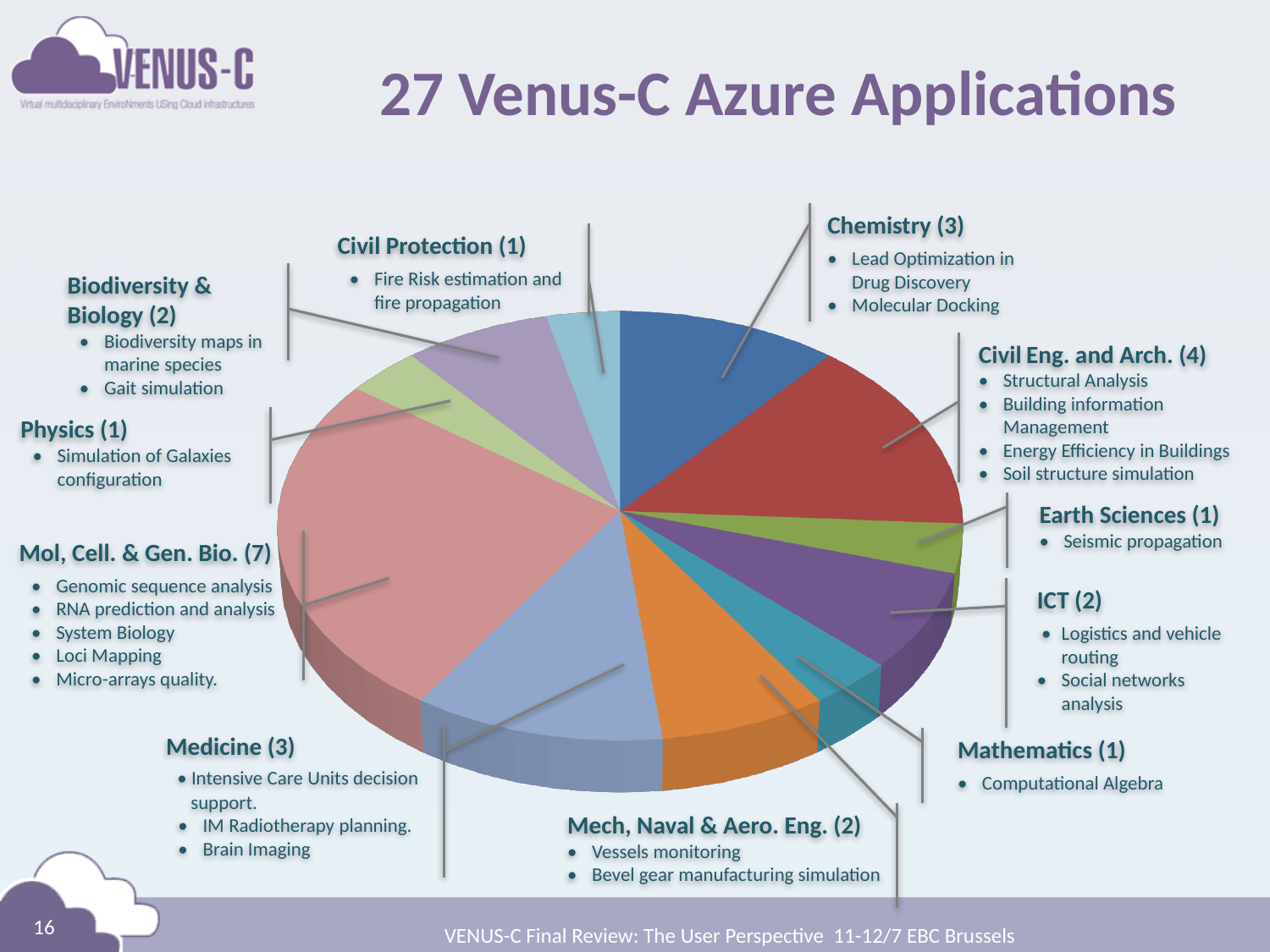
Which category has the largest number of applications? Mol, Cell. & Gen. Bio. How many applications are in the ICT category? 2 How many categories (application areas) does the pie chart show? 11 What is the difference between the number of applications in Mol, Cell. & Gen. Bio. and in Civil Eng. and Arch.? 3 How many applications are in the Chemistry category? 3 How many applications are in the Mol, Cell. & Gen. Bio. category? 7 Which has more applications, Civil Eng. and Arch. or Mech, Naval & Aero. Eng.? Civil Eng. and Arch. What is the difference between the number of applications in Chemistry and in Earth Sciences? 2 What is the title of the slide's chart? 27 Venus-C Azure Applications What kind of chart is shown on the slide? pie chart Which has more applications, Medicine or Mathematics? Medicine How many applications are in the Civil Eng. and Arch. category? 4